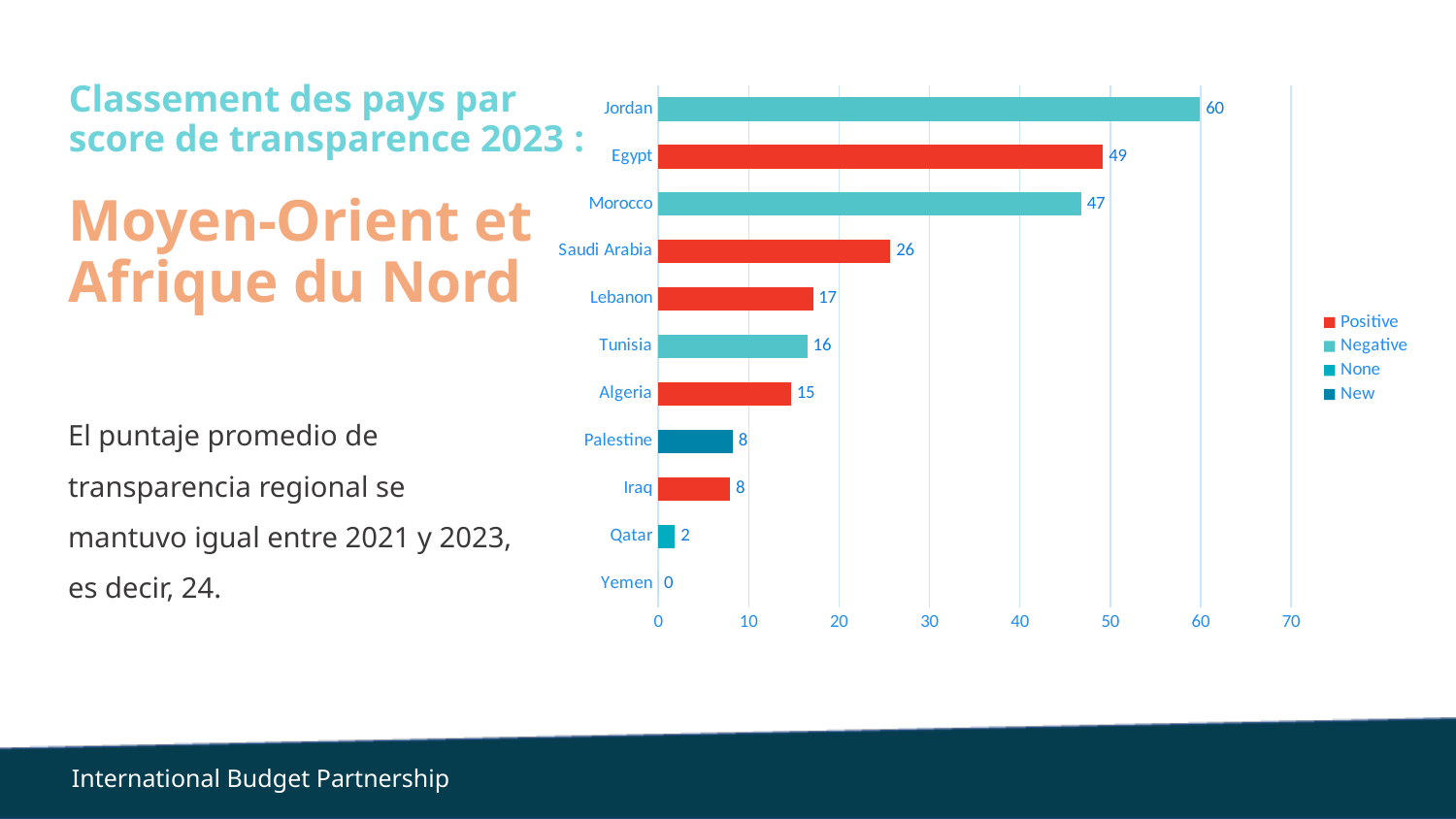
Which has a higher score, Lebanon or Algeria? Lebanon How many countries are shown in the chart? 11 Which country has the highest transparency score? Jordan Which legend category does the bar for Palestine belong to? New What is the transparency score for Tunisia? 16 What is the transparency score for Jordan? 60 Is the value for Saudi Arabia greater or less than 30? less How many entries does the legend list? 4 What is the difference between the scores of Egypt and Morocco? 2 What is the transparency score for Saudi Arabia? 26 Which country has the lowest transparency score? Yemen What kind of chart is shown on the slide? bar chart